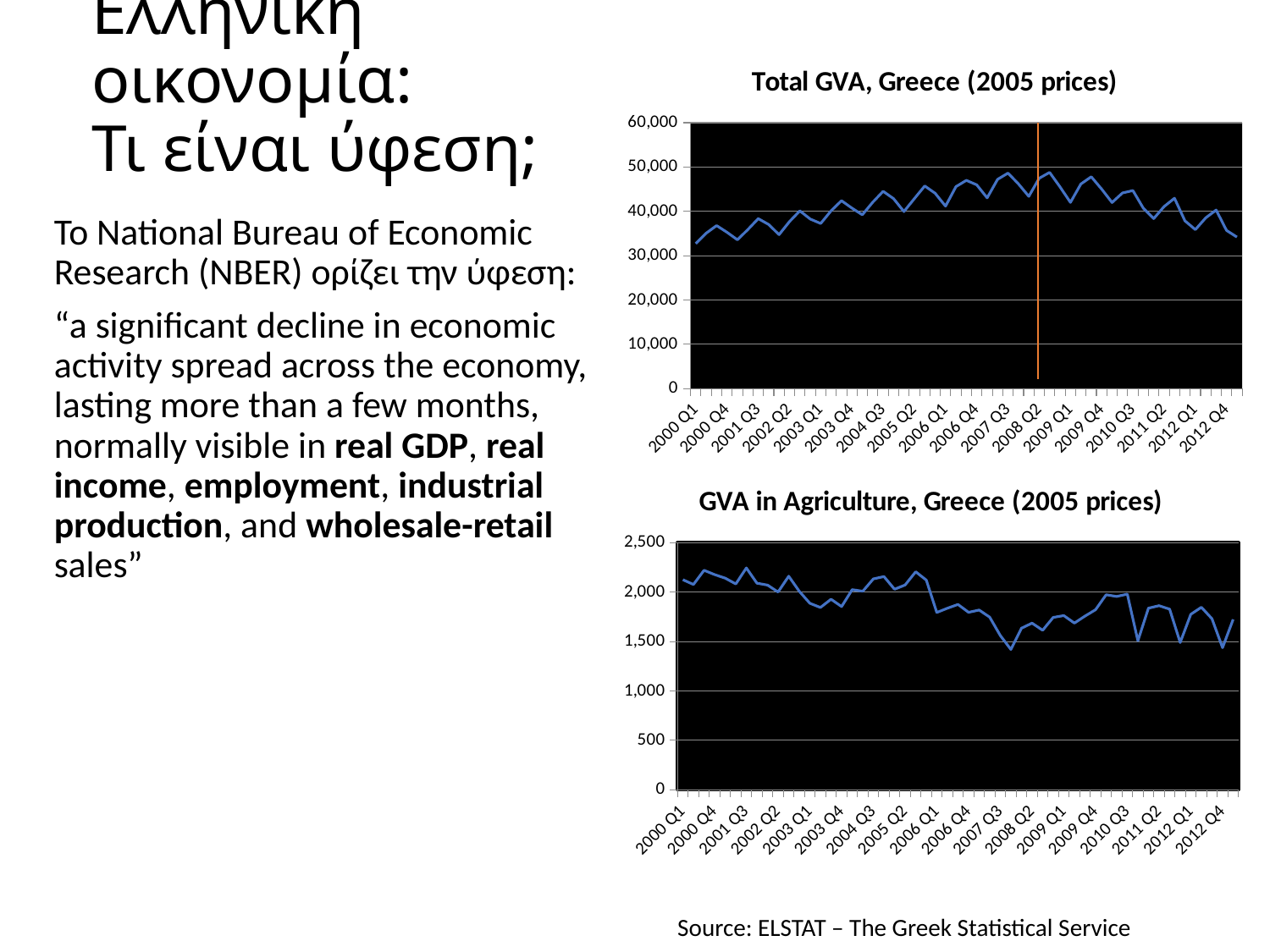
What kind of chart is the 'GVA in Agriculture, Greece (2005 prices)' chart? line chart In the 'GVA in Agriculture, Greece (2005 prices)' chart, is the value for 2012 Q4 greater or less than 2,000? less In the 'Total GVA, Greece (2005 prices)' chart, is the value for 2000 Q1 greater or less than 40,000? less In the 'Total GVA, Greece (2005 prices)' chart, is the value for 2012 Q4 greater or less than 40,000? less What is the highest value shown on the y axis of the 'GVA in Agriculture, Greece (2005 prices)' chart? 2,500 In the 'Total GVA, Greece (2005 prices)' chart, which is larger: the value around 2008 Q2 or the value at 2012 Q4? 2008 Q2 In the 'Total GVA, Greece (2005 prices)' chart, do the values generally rise or fall from 2009 Q1 to 2012 Q4? fall What kind of chart is the 'Total GVA, Greece (2005 prices)' chart? line chart In the 'GVA in Agriculture, Greece (2005 prices)' chart, which is larger: the value at 2000 Q1 or the value at 2012 Q4? 2000 Q1